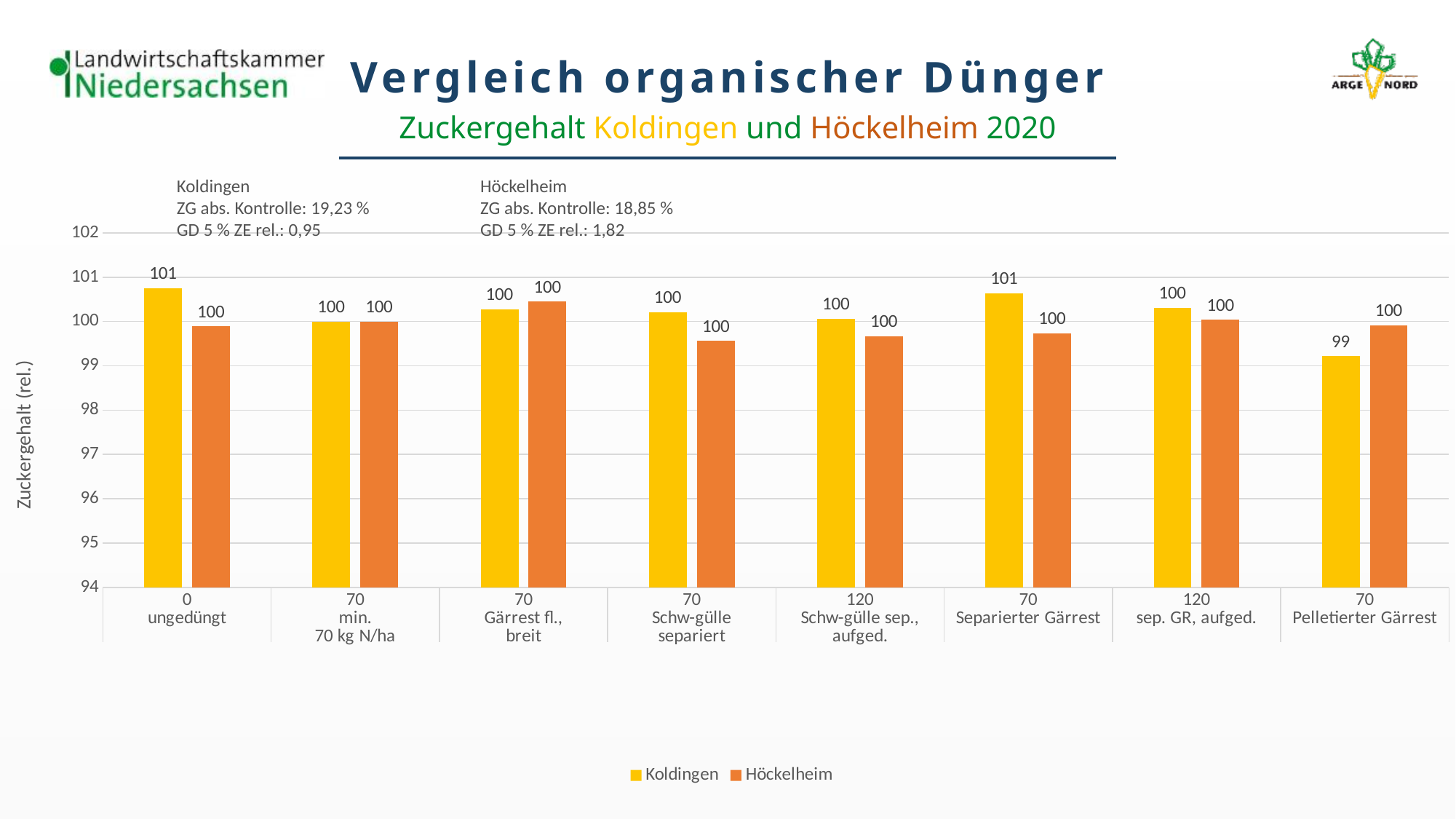
For '0 ungedüngt', which series has the larger value, Koldingen or Höckelheim? Koldingen What is the Koldingen value for the category '0 ungedüngt'? 101 Is the Koldingen value for '70 Pelletierter Gärrest' greater or less than 100? less What kind of chart is shown on the slide? bar chart What is the Koldingen value for '70 Pelletierter Gärrest'? 99 How many series does the legend list? 2 What is the label of the y axis? Zuckergehalt (rel.) Which category has the lowest Koldingen value? 70 Pelletierter Gärrest What is the Koldingen value for '70 Separierter Gärrest'? 101 What is the Höckelheim value for '70 Separierter Gärrest'? 100 How many categories are shown on the x axis? 8 For '70 Pelletierter Gärrest', which series has the larger value, Koldingen or Höckelheim? Höckelheim